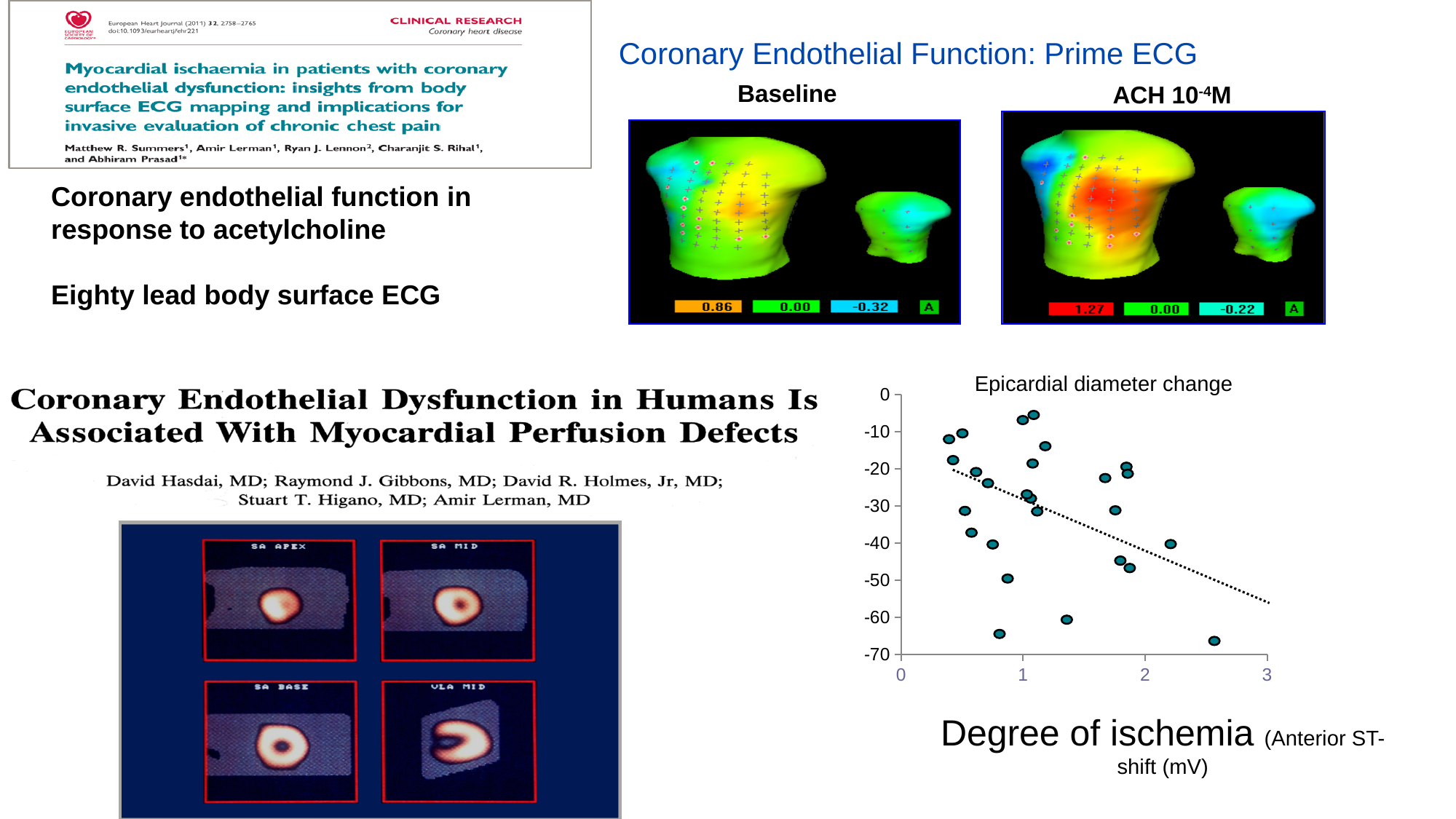
In the 'Epicardial diameter change' scatter chart, does the dotted trend line slope upward or downward from left to right? downward What kind of chart is shown at the bottom right of the slide, under the title 'Epicardial diameter change'? scatter chart In the 'Epicardial diameter change' scatter chart, is the value of the highest point (near a degree of ischemia of 1) greater or less than -10? greater In the 'Epicardial diameter change' scatter chart, is the value of the rightmost point (at a degree of ischemia of about 2.5) greater or less than -60? less In the 'Epicardial diameter change' scatter chart, are the two points plotted near a degree of ischemia of 1.8 and a diameter change of about -45 greater or less than -40? less In the 'Epicardial diameter change' scatter chart, do the plotted values generally rise or fall as the degree of ischemia increases along the x axis? fall What is the lowest tick value shown on the y axis of the 'Epicardial diameter change' scatter chart? -70 What is the highest tick value shown on the x axis of the 'Epicardial diameter change' scatter chart? 3